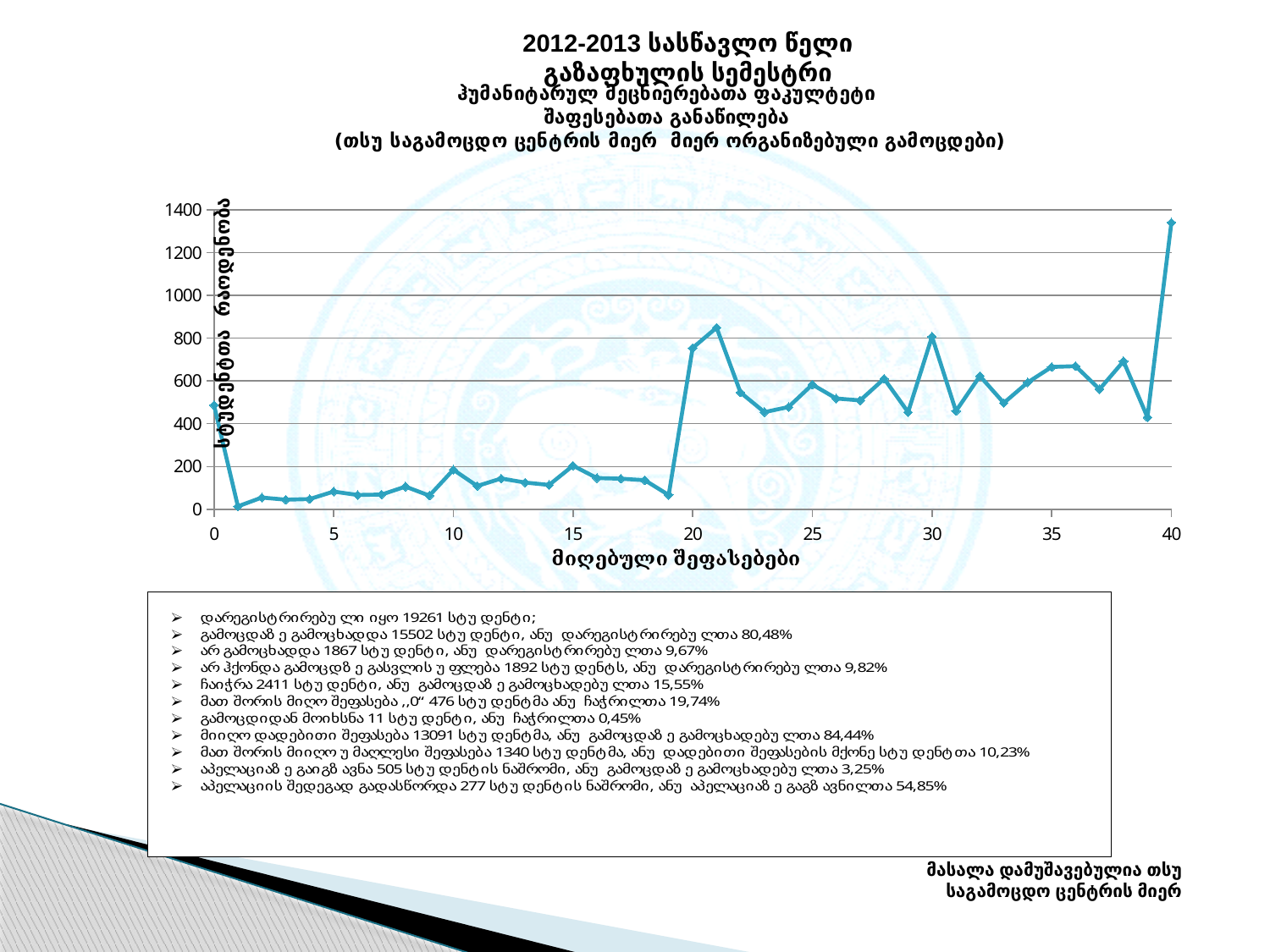
At which x-axis value (score) does the line reach its lowest point? 1 Is the value at x = 0 greater or less than 400? greater Is the value at x = 39 greater or less than 600? less Which has the larger value, x = 19 or x = 20? 20 Is the value at x = 20 greater or less than 600? greater What is the label of the x axis? მიღებული შეფასებები What kind of chart is shown on the slide? line chart At which x-axis value (score) does the line reach its highest point? 40 Does the line rise or fall between x = 19 and x = 21? rise Which has the larger value, x = 30 or x = 31? 30